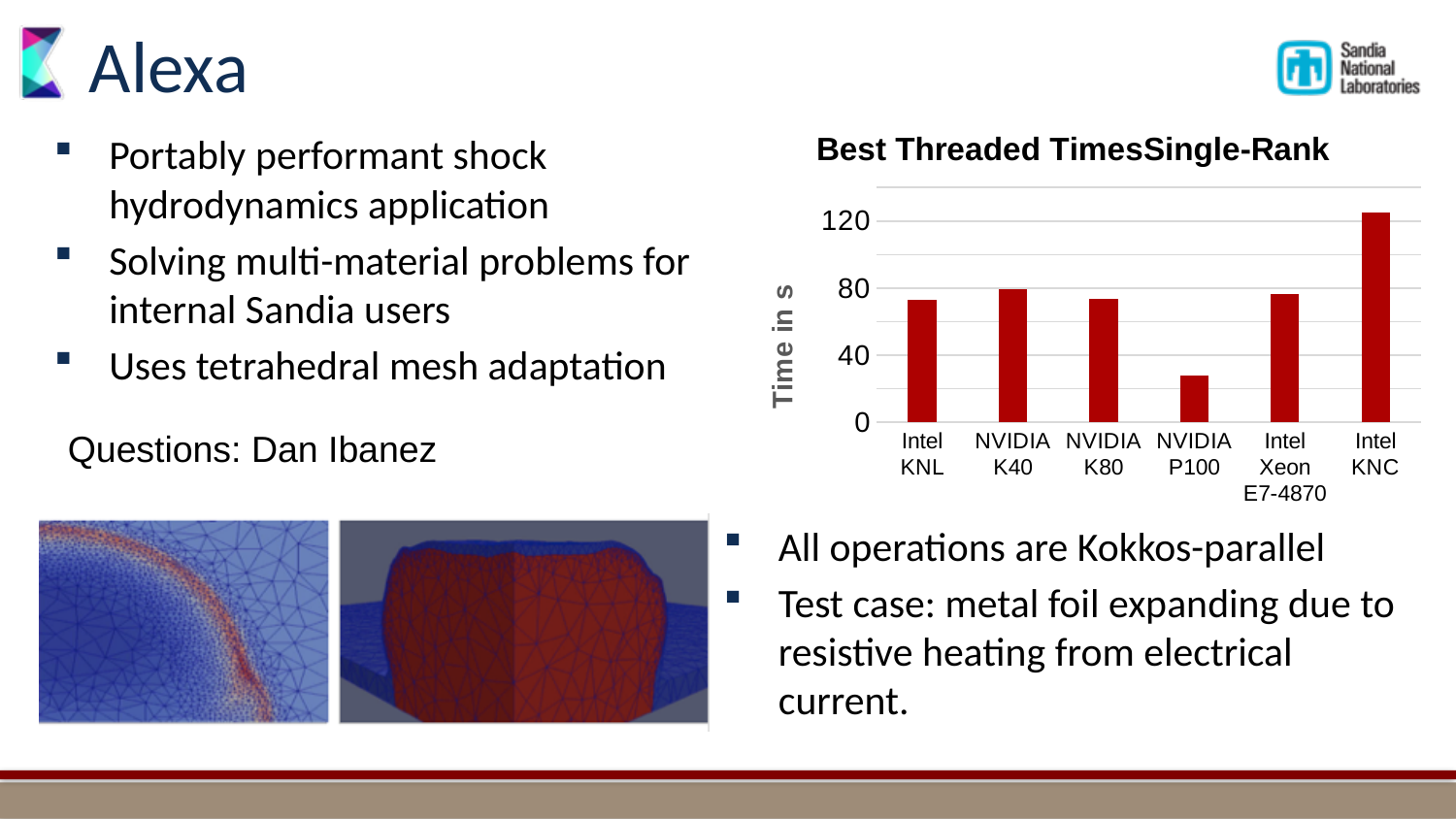
Which has a larger value, NVIDIA K40 or NVIDIA P100? NVIDIA K40 What is the label of the y axis of the chart? Time in s Which has a larger value, Intel KNC or NVIDIA P100? Intel KNC Is the value for Intel KNC greater or less than 120? greater Which category has the highest time in the chart? Intel KNC What kind of chart is shown on the slide? bar chart Which category has the lowest time in the chart? NVIDIA P100 Is the value for NVIDIA P100 greater or less than 40? less Is the value for Intel KNL greater or less than 80? less What is the title of the chart? Best Threaded TimesSingle-Rank How many categories (processors) are shown on the x axis of the chart? 6